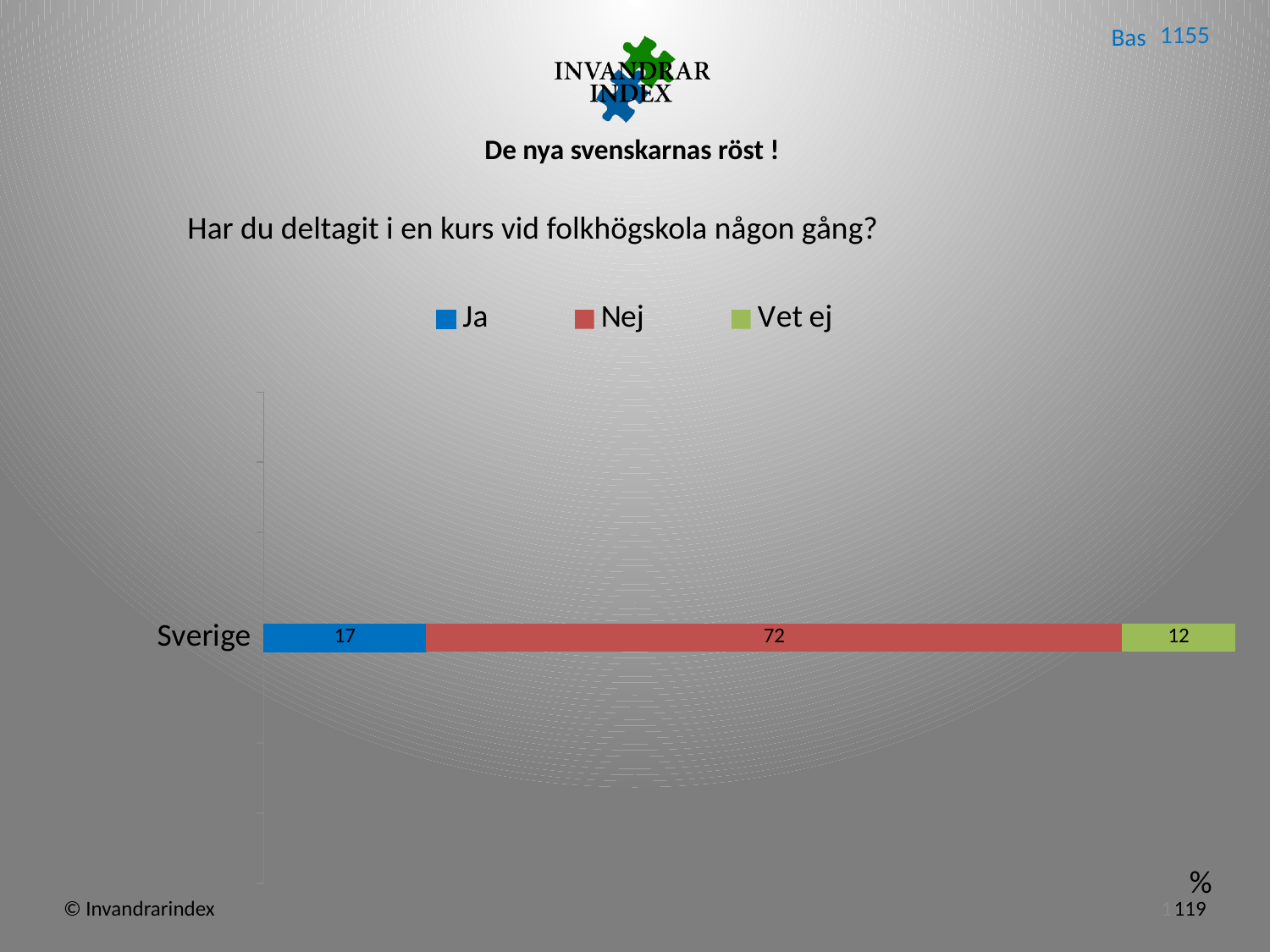
What is the value for Ja for Sverige? 17 What is the value for Nej for Sverige? 72 Which is larger for Sverige, Ja or Vet ej? Ja How many categories are shown on the chart? 1 What kind of chart is shown on the slide? Stacked bar chart What is the value for Vet ej for Sverige? 12 Which series has the highest value for Sverige? Nej How many series does the legend list? 3 What is the difference between the Nej and Ja values for Sverige? 55 Which series has the lowest value for Sverige? Vet ej What is the total of the stacked bar for Sverige? 101 What question does the chart title ask? Har du deltagit i en kurs vid folkhögskola någon gång?